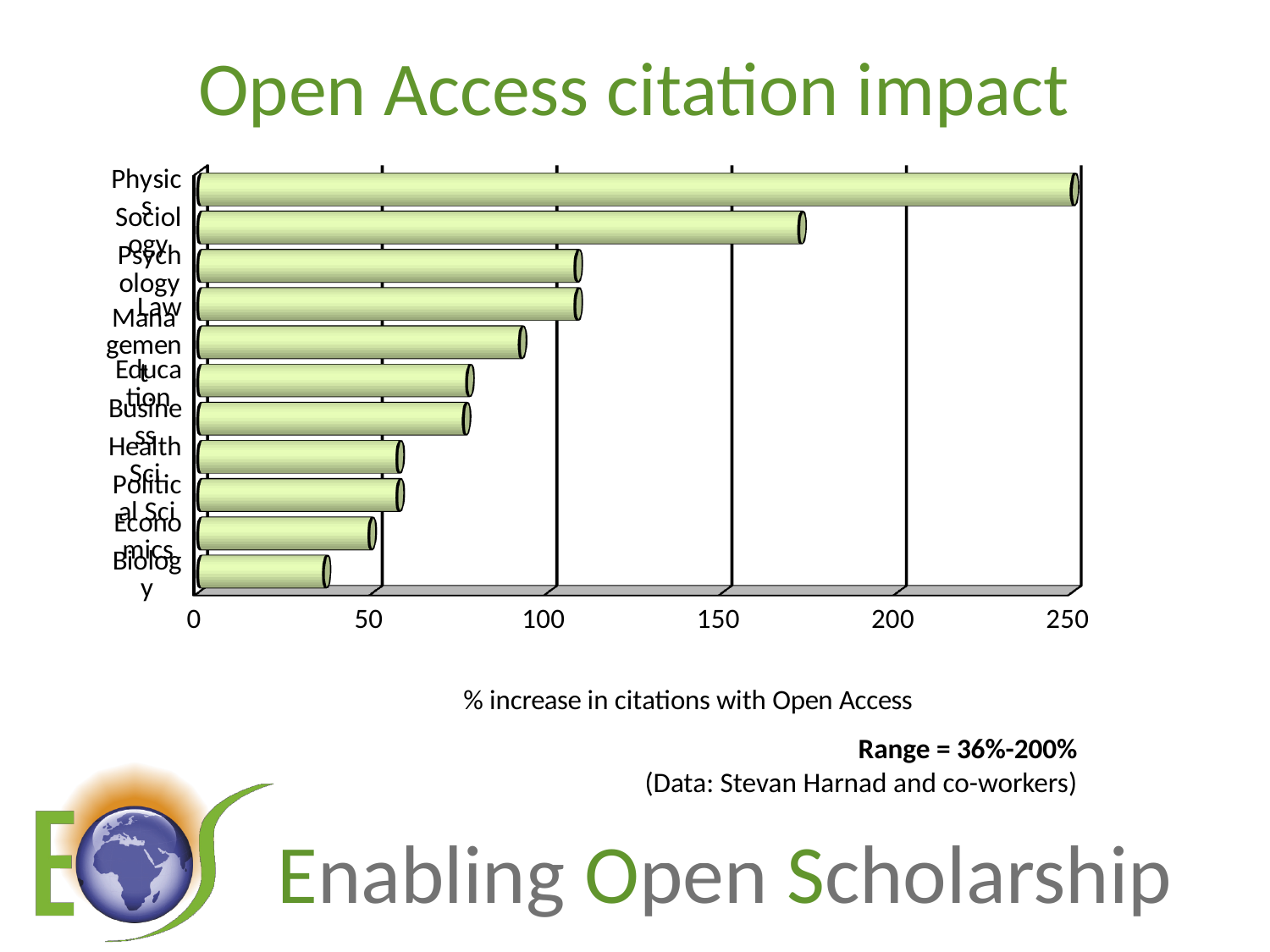
Which category has the highest % increase in citations with Open Access? Physics How many categories (disciplines) are plotted in the chart? 11 Which has a larger value, Sociology or Psychology? Sociology Is the value for Biology greater or less than 50? less Which has a larger value, Management or Health Sci? Management Which category has the lowest % increase in citations with Open Access? Biology Is the value for Management greater or less than 100? less Is the value for Education greater or less than 50? greater What is the title of the chart on the slide? Open Access citation impact What kind of chart is shown on the slide? bar chart